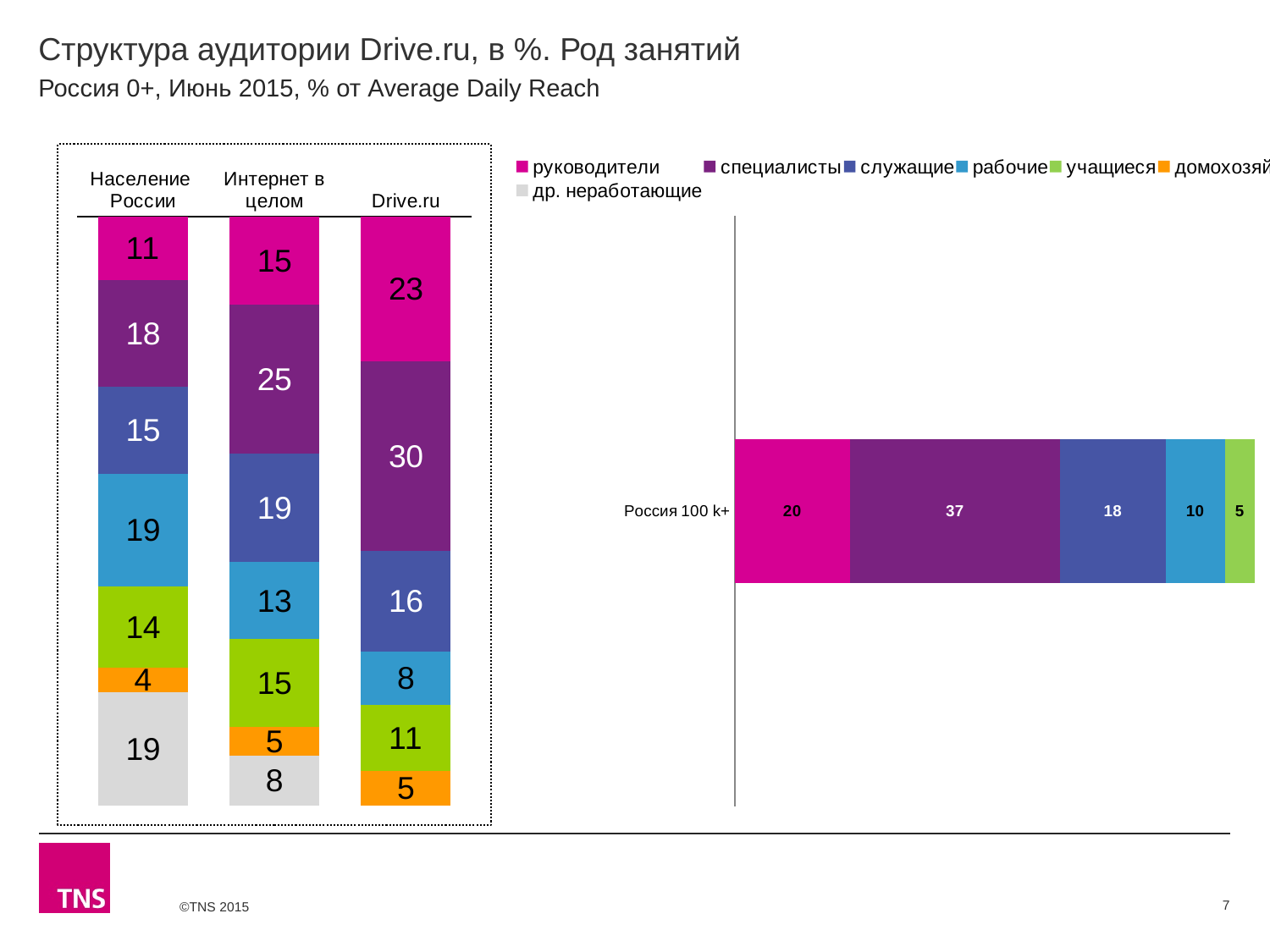
In the left chart, what is the value for руководители in the Население России column? 11 In the right chart, what is the total of the labelled segments for Россия 100 k+? 90 In the left chart, which category has the largest segment in the Drive.ru column? специалисты In the left chart, which is larger: the служащие value for Интернет в целом or for Drive.ru? Интернет в целом How many series does the legend list? 7 In the left chart, what is the value for специалисты in the Drive.ru column? 30 What kind of chart is the right chart? stacked bar chart In the right chart, which category has the smallest segment for Россия 100 k+? учащиеся In the left chart, what is the value for рабочие in the Интернет в целом column? 13 In the right chart, what is the value for специалисты for Россия 100 k+? 37 How many columns (audience groups) does the left chart show? 3 In the left chart, what is the difference between the руководители values for Drive.ru and Население России? 12